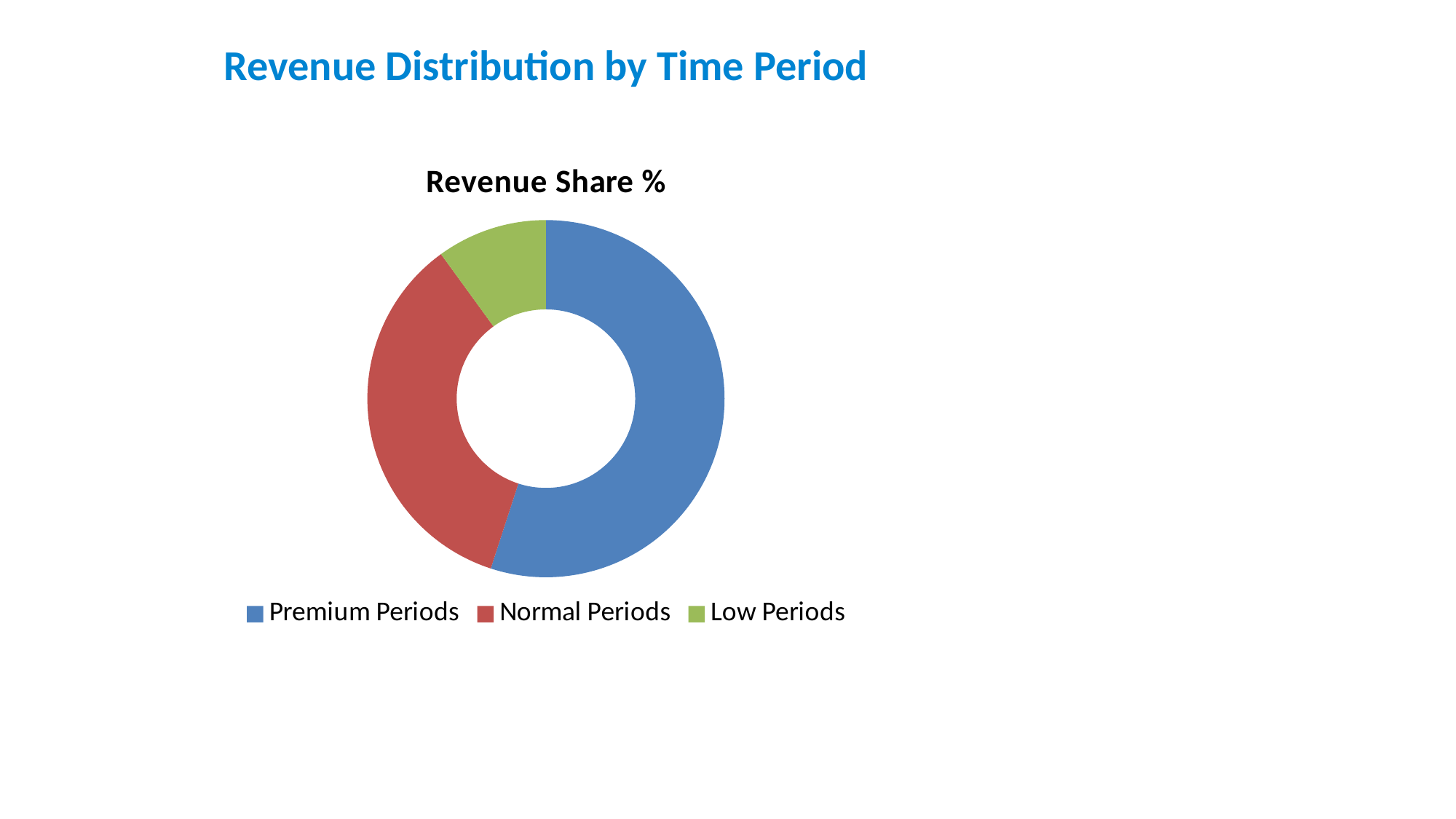
Which category has the smallest share of revenue? Low Periods Which has a larger revenue share, Normal Periods or Low Periods? Normal Periods Which category has the largest share of revenue? Premium Periods How many categories does the chart show? 3 Which colour represents Low Periods in the chart? green What kind of chart is shown on the slide? doughnut chart What is the title of the chart? Revenue Share % Which has a larger revenue share, Premium Periods or Normal Periods? Premium Periods